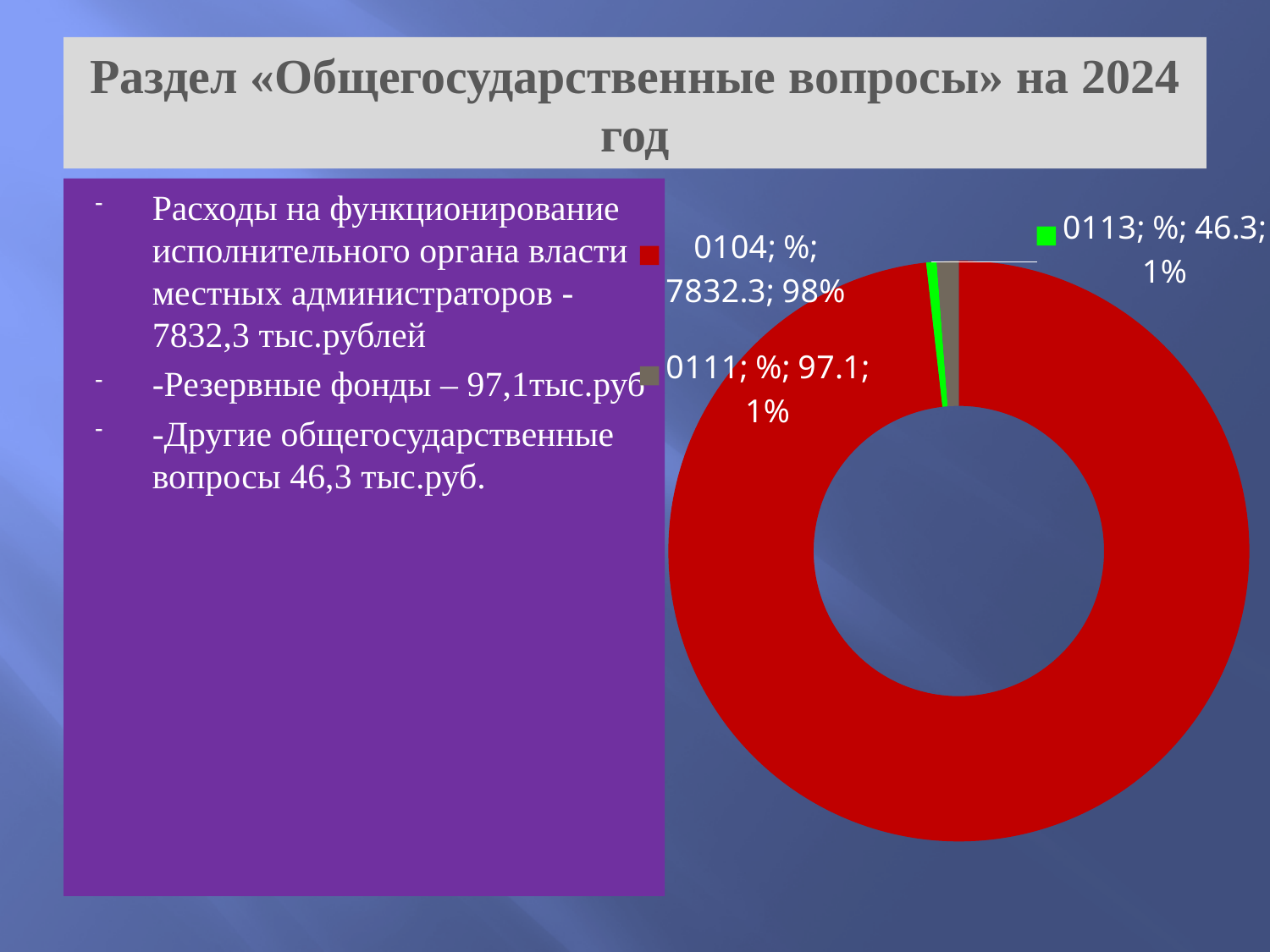
Which category has the smallest value? 0113 What type of chart is shown on the slide? doughnut chart What colour is the slice for category 0113? green What is the value shown for category 0113? 46.3 What is the value shown for category 0104? 7832.3 What is the value shown for category 0111? 97.1 What share of the chart does category 0104 represent? 98% What is the difference between the values for 0111 and 0113? 50.8 Which has the larger value, 0111 or 0113? 0111 What share of the chart does category 0111 represent? 1% How many slices does the chart have? 3 Which category has the largest slice? 0104